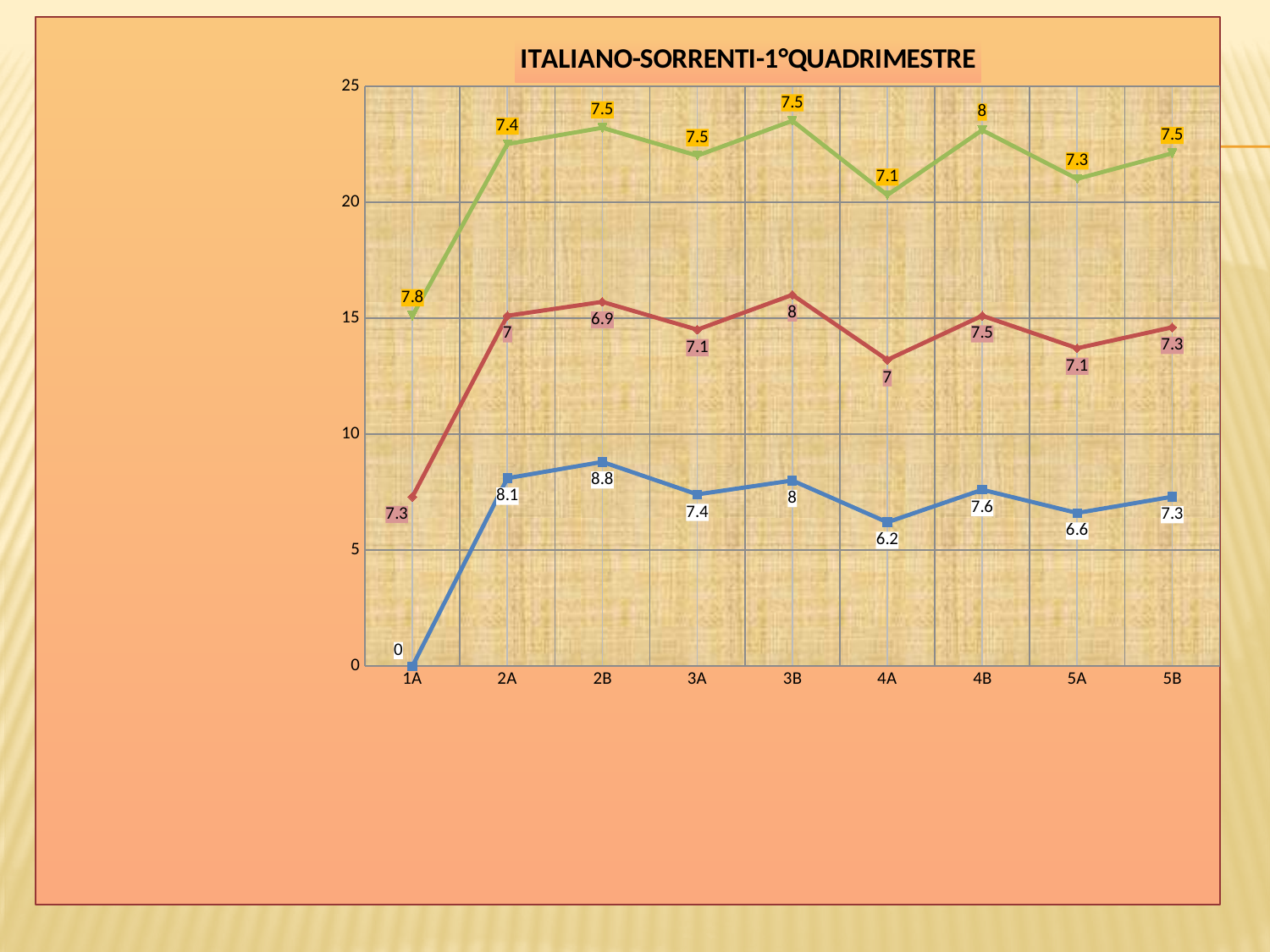
Which is larger in the red series, the value for 3B or the value for 4A? 3B Which category has the lowest value in the blue series? 1A What is the value of the blue series for 1A? 0 What is the title of the chart? ITALIANO-SORRENTI-1°QUADRIMESTRE What is the value of the green series for 1A? 7.8 What is the value of the red series for 3B? 8 What is the value of the green series for 4B? 8 What kind of chart is shown on the slide? line chart What is the value of the blue series for 2B? 8.8 What is the difference between the blue series values for 2B and 4A? 2.6 How many categories are shown on the x axis? 9 Which category has the highest value in the green series? 4B